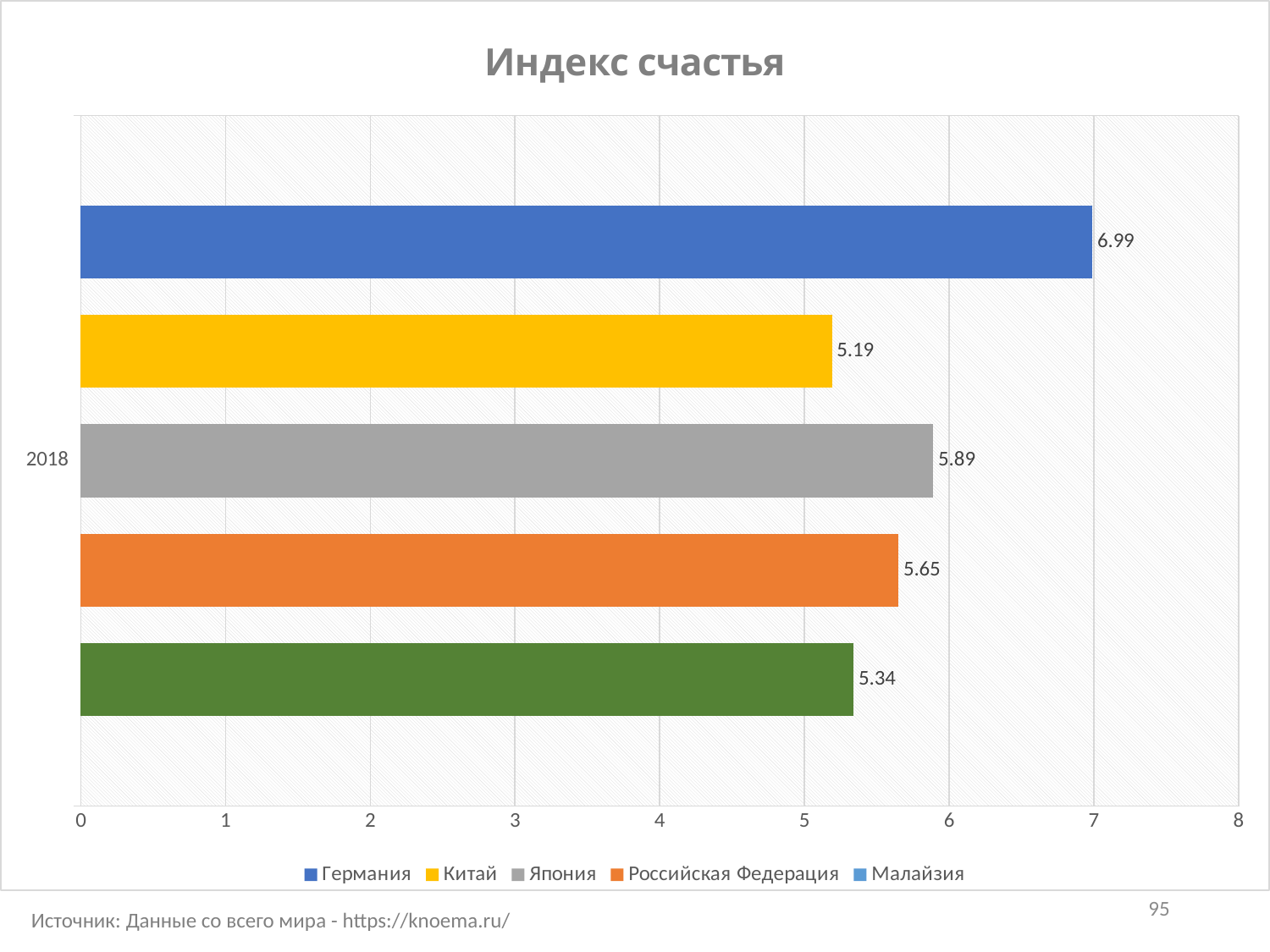
What is the title of the chart? Индекс счастья Which has a higher happiness index, Япония or Российская Федерация? Япония How many series does the legend list? 5 What is the happiness index value for Германия? 6.99 Which country has the lowest happiness index on the chart? Китай Which country has the highest happiness index on the chart? Германия What kind of chart is shown on the slide? Bar chart What is the happiness index value for Российская Федерация? 5.65 What is the happiness index value for Япония? 5.89 What is the difference between the happiness index of Германия and Китай? 1.80 What is the happiness index value for Китай? 5.19 What is the difference between the happiness index of Япония and Российская Федерация? 0.24